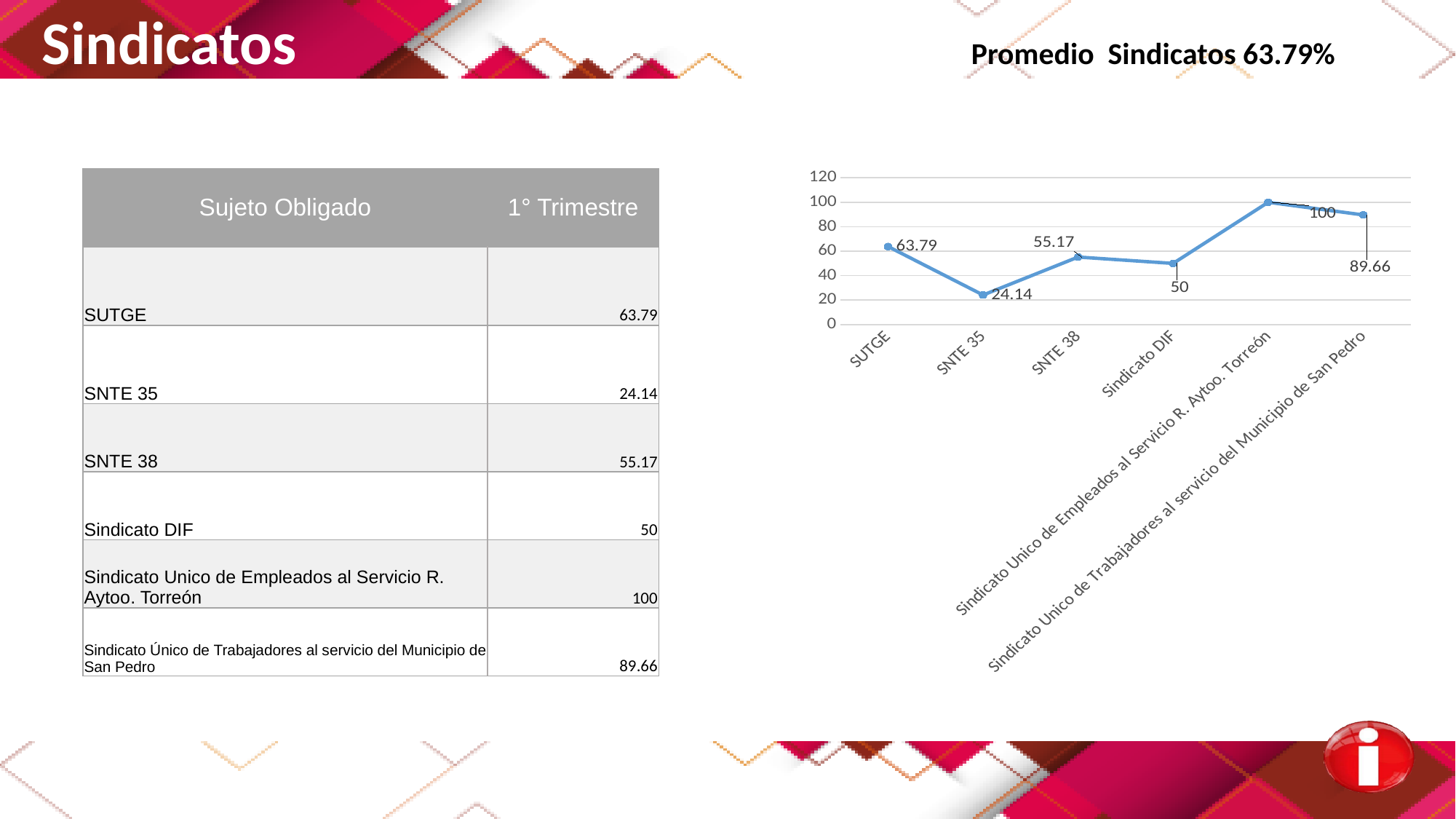
What is the highest tick value shown on the y axis of the chart? 120 Is the value for SNTE 38 greater or less than 40? greater How many categories are plotted on the x axis of the chart? 6 What is the value for SUTGE in the chart? 63.79 What is the value for SNTE 35 in the chart? 24.14 What is the value for Sindicato Unico de Trabajadores al servicio del Municipio de San Pedro? 89.66 What type of chart is shown on the slide? line chart Which category has the highest value in the chart? Sindicato Unico de Empleados al Servicio R. Aytoo. Torreón Which category has the lowest value in the chart? SNTE 35 What is the value for Sindicato DIF in the chart? 50 Which is larger, the value for SUTGE or the value for Sindicato DIF? SUTGE What is the difference between the values for SNTE 38 and SNTE 35? 31.03